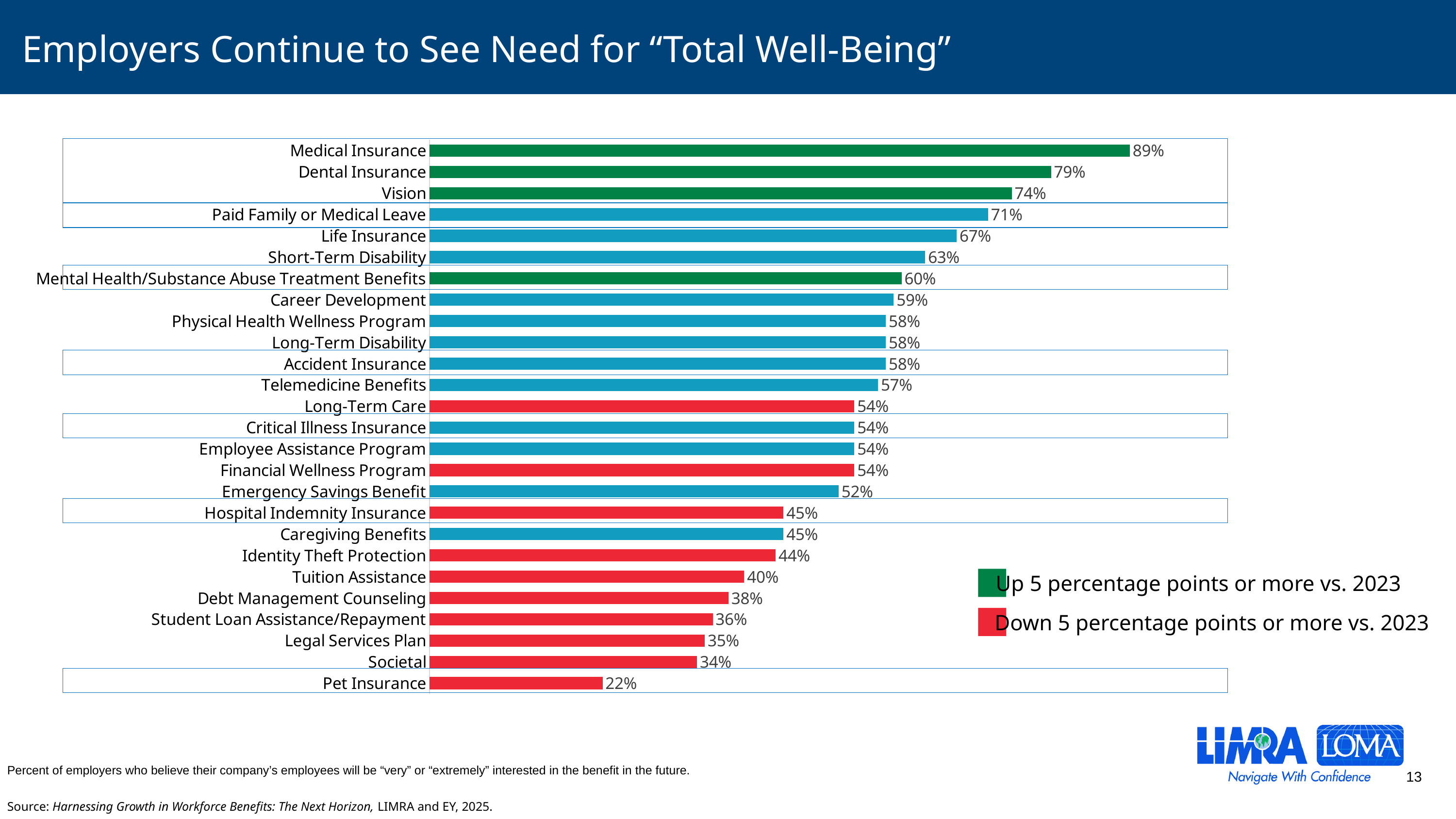
What is the difference between the values for Medical Insurance and Dental Insurance? 10% Which benefit has the highest value on the chart? Medical Insurance According to the legend, what does a green bar indicate? Up 5 percentage points or more vs. 2023 How many benefit categories are shown on the chart? 26 What type of chart is shown on the slide? Bar chart Which benefit has the lowest value on the chart? Pet Insurance Which has a higher value, Life Insurance or Career Development? Life Insurance What is the difference between the values for Paid Family or Medical Leave and Societal? 37% What percentage of employers believe employees will be interested in Medical Insurance? 89% What is the value shown for Emergency Savings Benefit? 52% What is the value shown for Pet Insurance? 22% What is the value shown for Mental Health/Substance Abuse Treatment Benefits? 60%